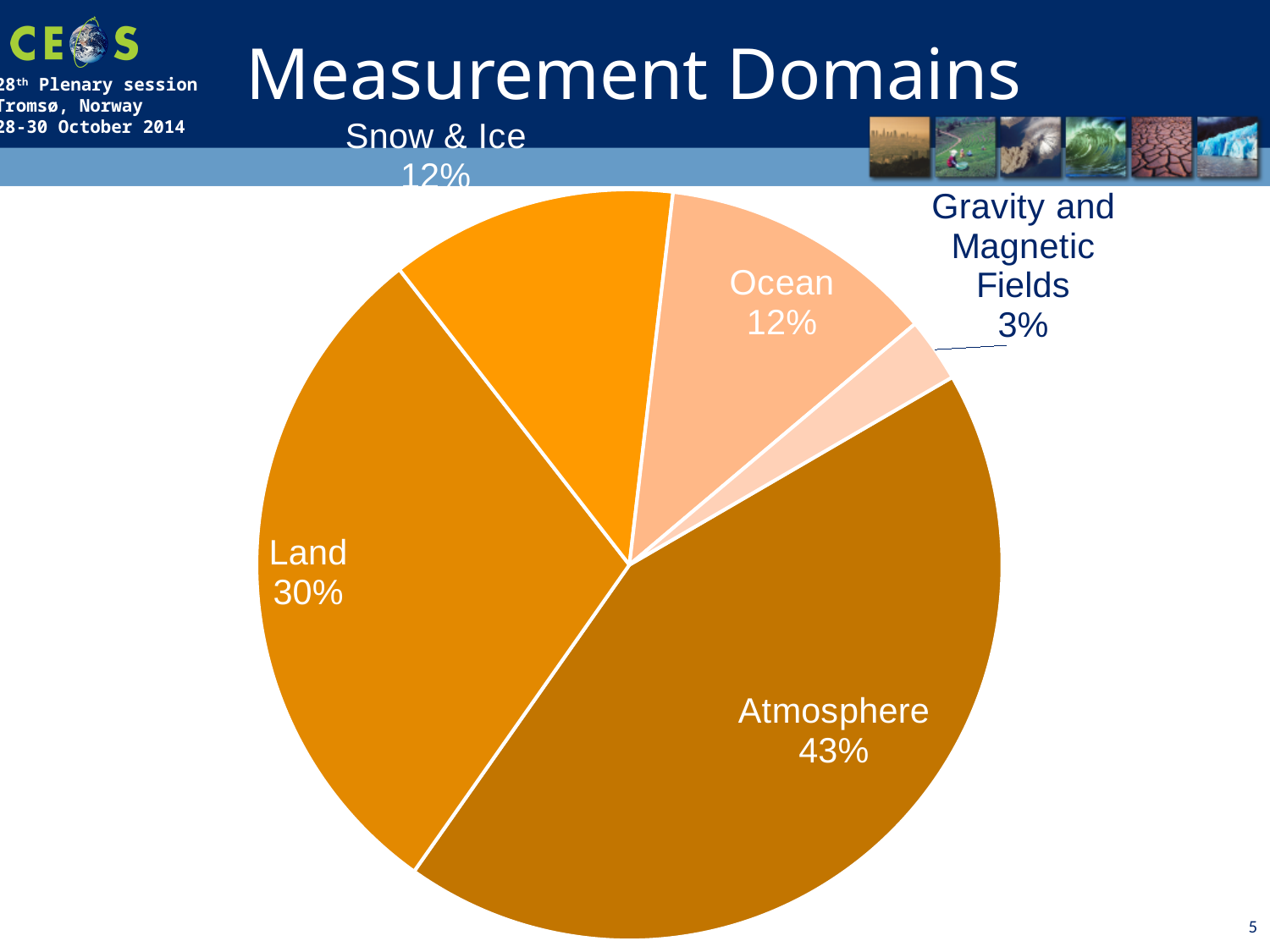
What is the value shown for Ocean? 12% What is the difference between the Atmosphere and Land percentages? 13% Which category has the largest slice of the pie? Atmosphere What is the value shown for Gravity and Magnetic Fields? 3% What is the value shown for Snow & Ice? 12% Which is larger, the Land slice or the Ocean slice? Land What is the title of the slide containing the chart? Measurement Domains What share of the pie does Atmosphere represent? 43% How many categories are shown in the pie chart? 5 What kind of chart is shown on the slide? pie chart Which category has the smallest slice of the pie? Gravity and Magnetic Fields What share of the pie does Land represent? 30%